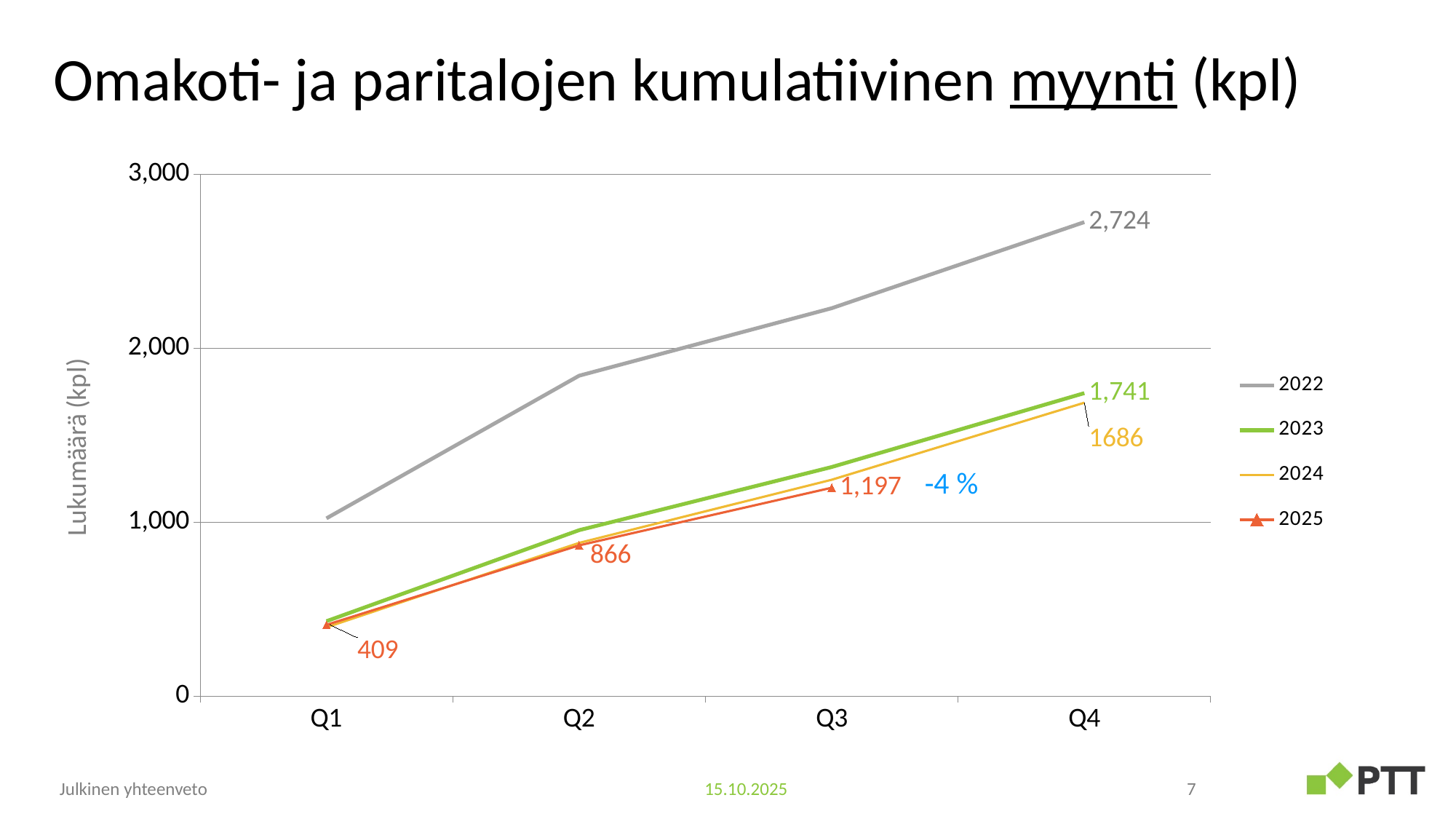
Is the value for 2022 at Q2 greater or less than 2,000? less How many series does the legend list? 4 What is the title of the chart? Omakoti- ja paritalojen kumulatiivinen myynti (kpl) What is the value for 2025 at Q3? 1,197 What is the value for 2023 at Q4? 1,741 What is the value for 2022 at Q4? 2,724 What is the difference between the 2025 values at Q2 and Q1? 457 Which series has the highest value at Q4? 2022 What type of chart is shown on the slide? line chart What is the value for 2024 at Q4? 1686 Does the 2022 line rise or fall from Q1 to Q4? rise What is the value for 2025 at Q1? 409